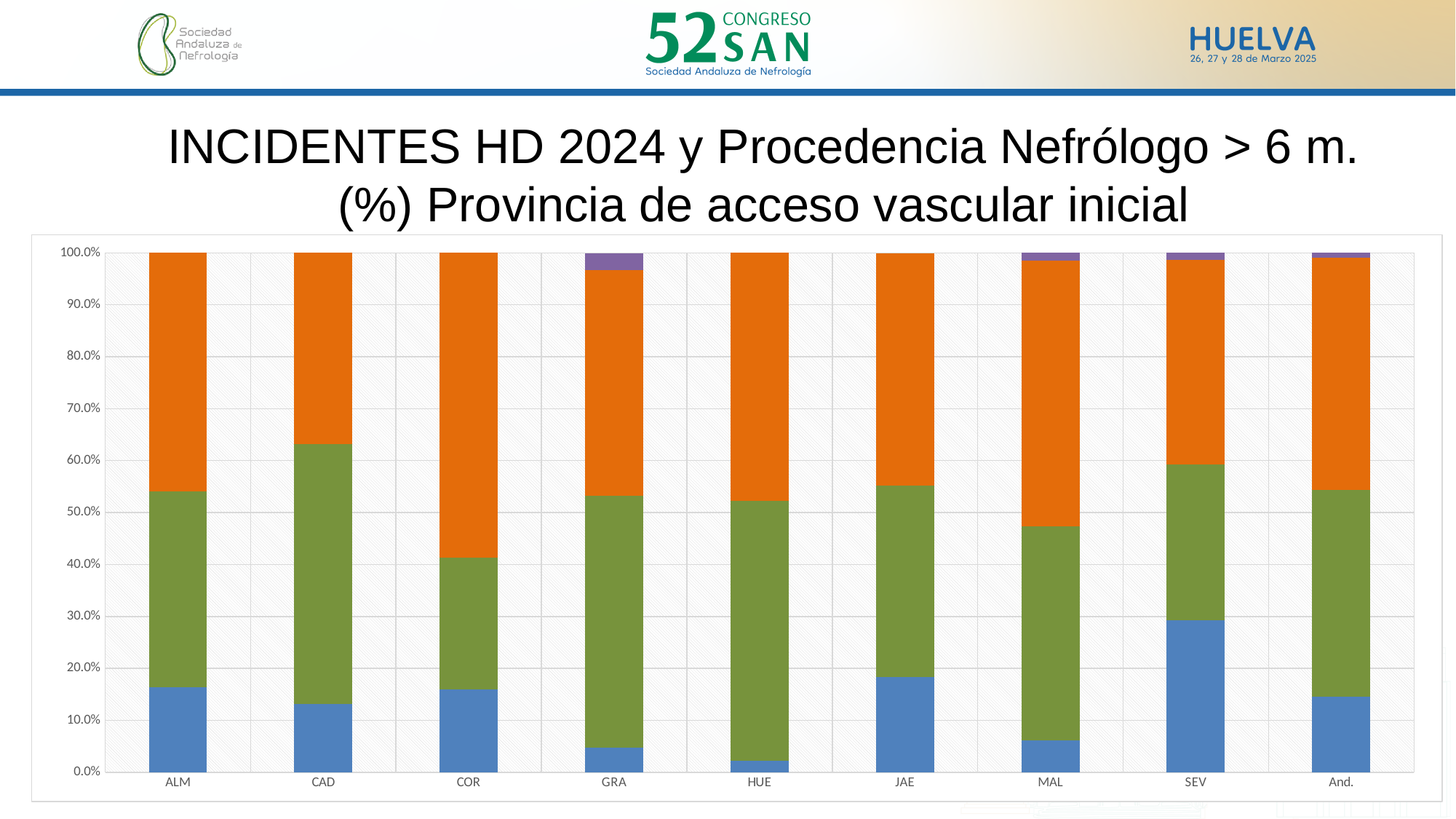
How many categories are shown along the x axis of the chart? 9 Which has the larger blue (bottom) segment, SEV or ALM? SEV Does the top of the green segment for COR lie above or below the 50.0% line? below What is the total height of the stacked bar for ALM? 100.0% What kind of chart is shown on the slide? stacked bar chart Does the top of the green segment for CAD lie above or below the 60.0% line? above Which category has the smallest orange segment? CAD Which category has the largest blue (bottom) segment? SEV Which category has the largest orange segment? COR What is the title of the slide containing the chart? INCIDENTES HD 2024 y Procedencia Nefrólogo > 6 m. (%) Provincia de acceso vascular inicial Is the blue (bottom) segment for HUE greater or less than 10.0%? less